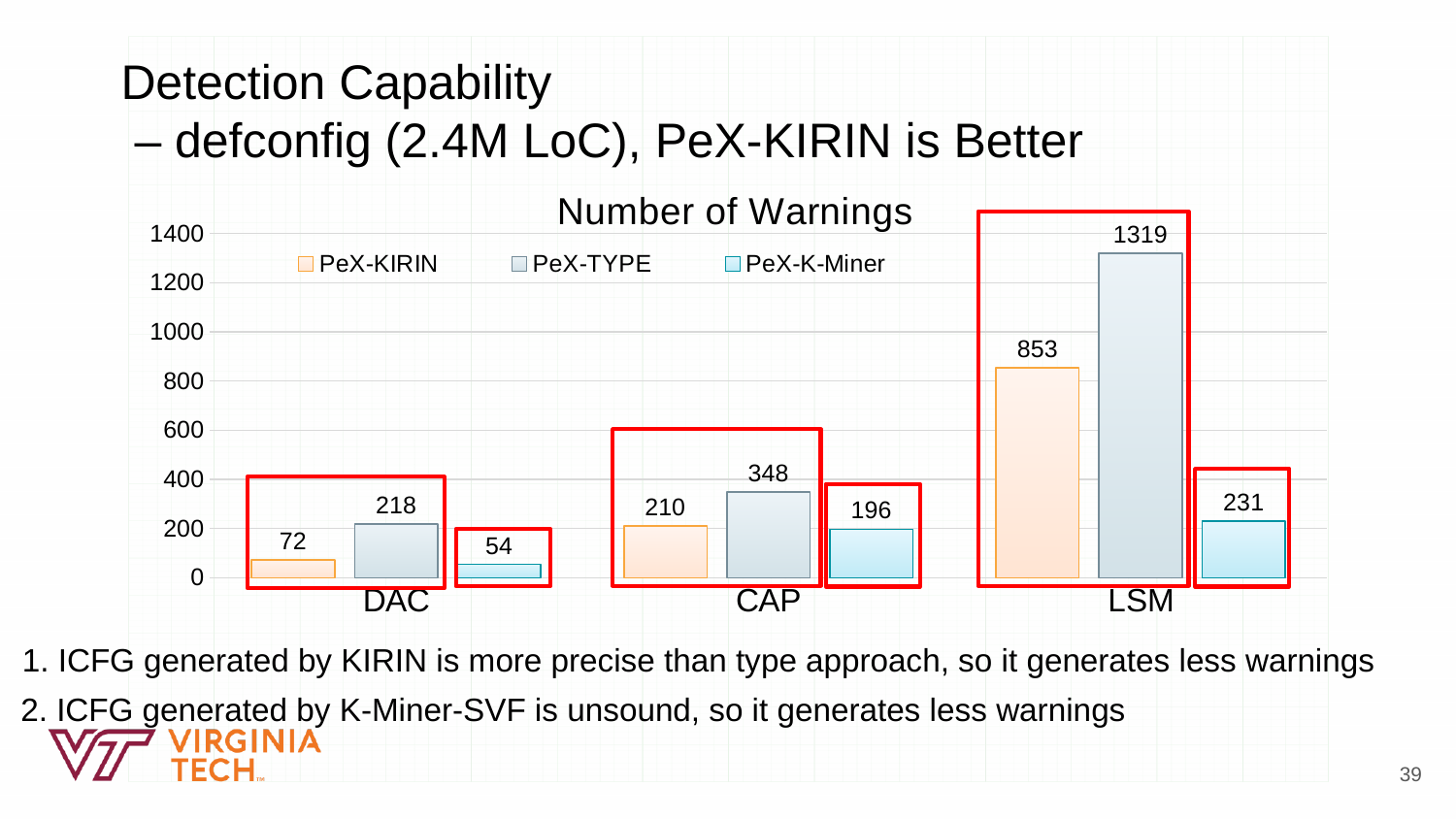
What is the number of warnings for PeX-K-Miner on CAP? 196 Which series has more warnings on LSM, PeX-KIRIN or PeX-K-Miner? PeX-KIRIN What is the number of warnings for PeX-KIRIN on DAC? 72 Is the value for PeX-TYPE on LSM greater or less than 1200? greater Which category has the highest number of warnings for PeX-KIRIN? LSM Which category has the lowest number of warnings for PeX-K-Miner? DAC What is the number of warnings for PeX-TYPE on LSM? 1319 What kind of chart is shown on the slide? bar chart What is the title of the chart? Number of Warnings What is the difference between PeX-TYPE and PeX-KIRIN warnings on CAP? 138 How many series does the legend list? 3 How many categories are shown on the x axis? 3